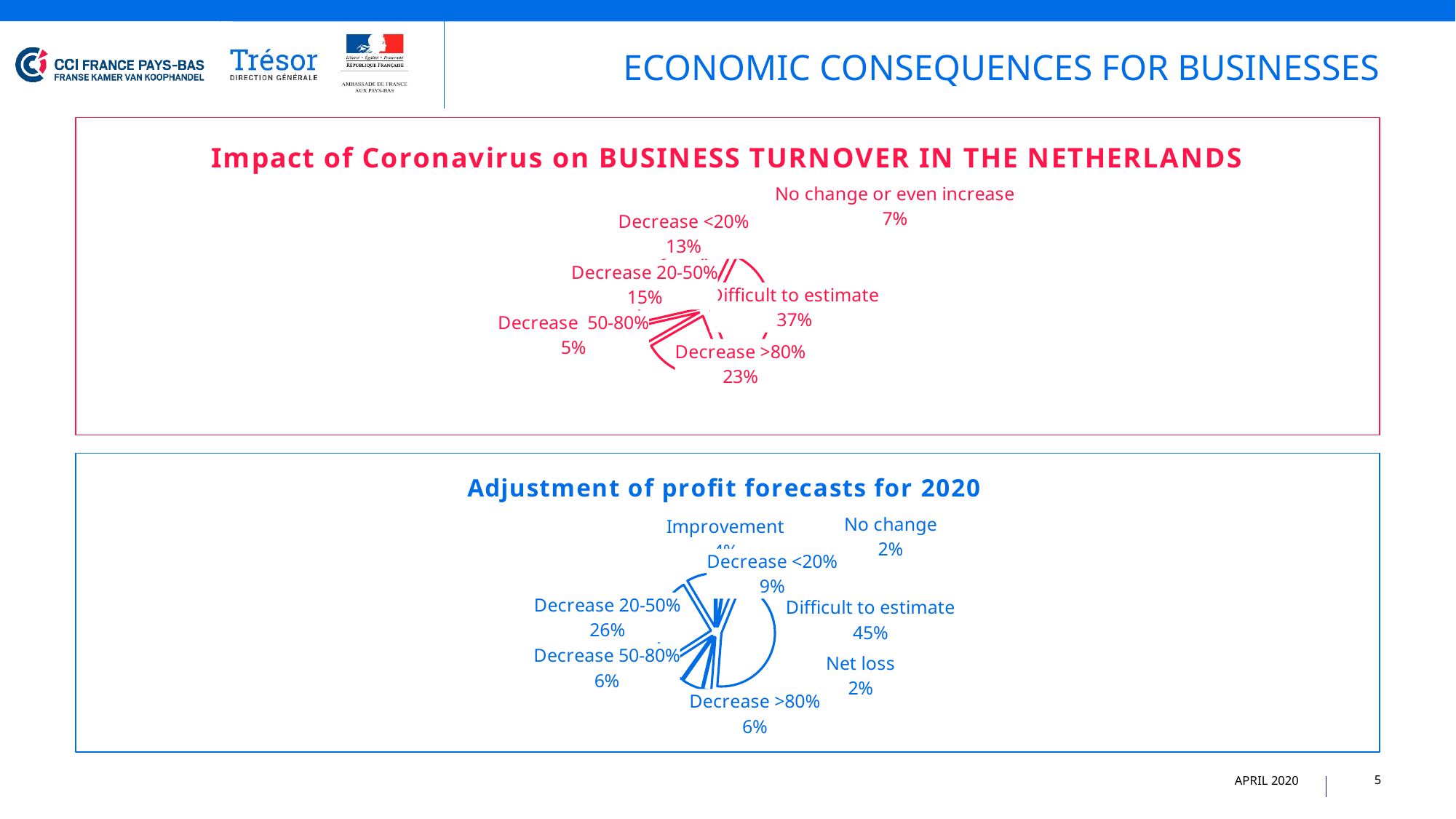
In the top chart on business turnover, how many categories are shown? 6 In the chart 'Adjustment of profit forecasts for 2020', how many categories are shown? 8 In the top chart on business turnover, what is the difference between 'Decrease 20-50%' and 'Decrease <20%'? 2% In the top chart on business turnover, what percentage reported a decrease of more than 80%? 23% What type of chart is used for 'Adjustment of profit forecasts for 2020'? Pie chart In the chart 'Adjustment of profit forecasts for 2020', what share is 'Difficult to estimate'? 45% In the top chart on business turnover, which category has the smallest share? Decrease 50-80% In the chart titled 'Impact of Coronavirus on BUSINESS TURNOVER IN THE NETHERLANDS', what share of businesses answered 'Difficult to estimate'? 37% In the chart 'Adjustment of profit forecasts for 2020', which is larger: 'Decrease <20%' or 'Decrease 50-80%'? Decrease <20% In the chart 'Adjustment of profit forecasts for 2020', what percentage reported a decrease of 20-50%? 26% In the top chart on business turnover, which category has the largest share? Difficult to estimate In the chart 'Adjustment of profit forecasts for 2020', what is the difference between 'Difficult to estimate' and 'Decrease 20-50%'? 19%